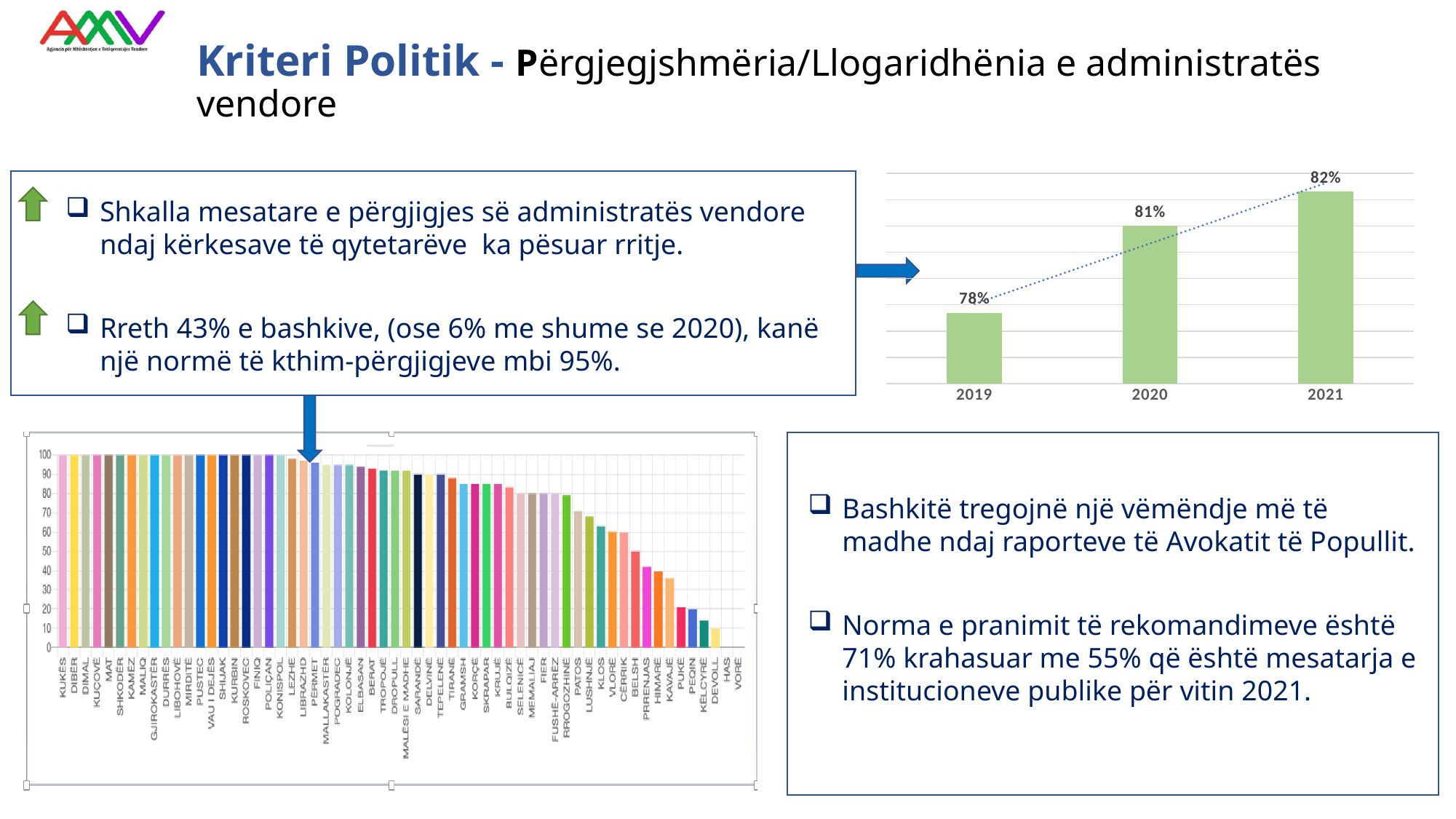
In the bottom-left chart, is the value for KUKËS greater or less than 90? greater In the bottom-left chart, do the values generally rise or fall from left to right along the x axis? fall In the top-right chart, which year has the lowest value? 2019 What kind of chart is the bottom-left chart? bar chart In the top-right chart, which year has the highest value? 2021 In the bottom-left chart, is the value for BELSH greater or less than 70? less In the top-right chart, what is the value for 2020? 81% In the top-right chart, do the values rise or fall from 2019 to 2021? rise In the top-right chart, what is the value for 2021? 82% In the top-right chart, how many years are plotted? 3 In the top-right chart, what is the value for 2019? 78%